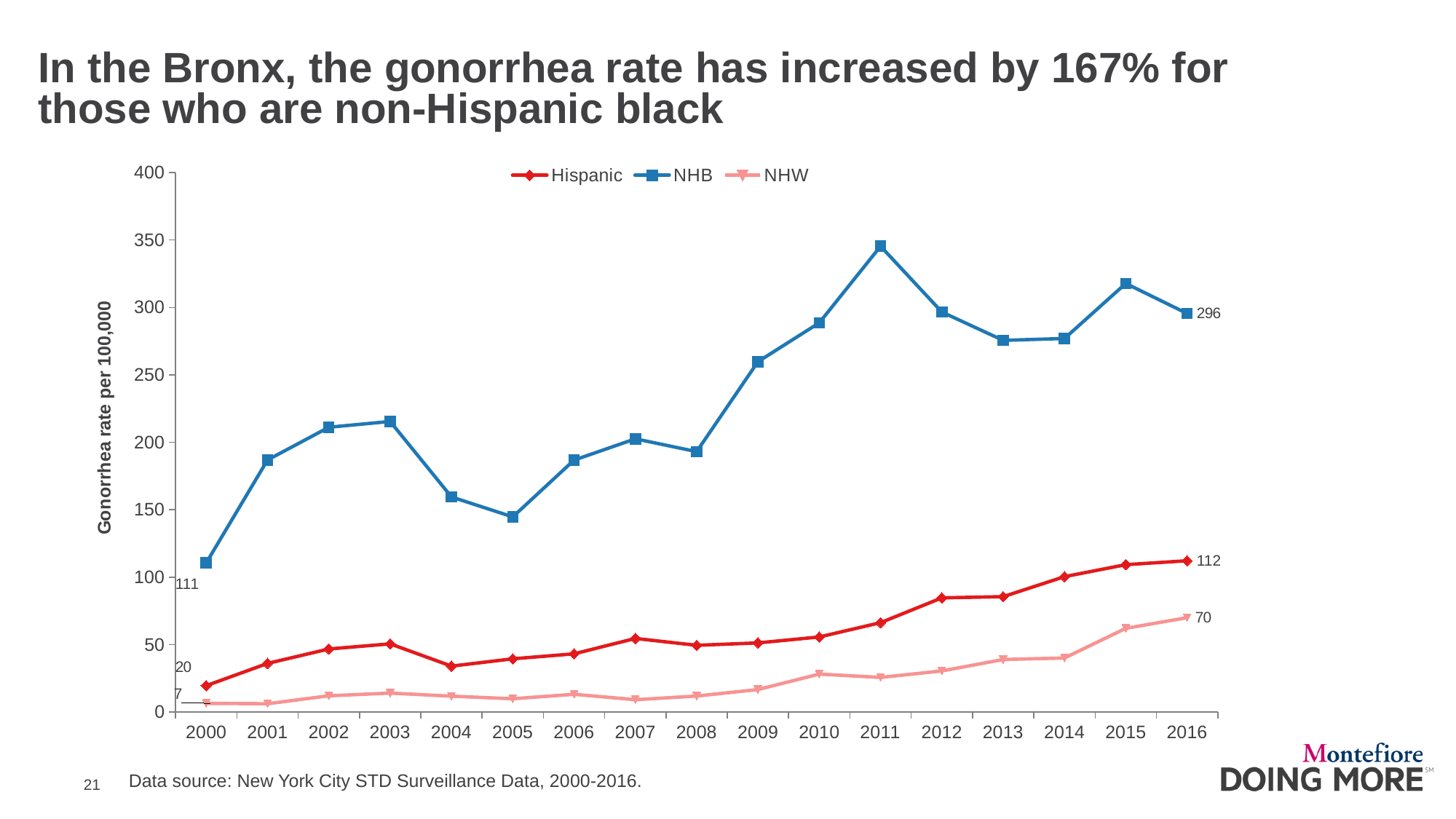
What is the gonorrhea rate for Hispanic in 2016? 112 How many series does the legend list? 3 What is the gonorrhea rate for NHB in 2000? 111 By how much did the NHB gonorrhea rate increase from 2000 to 2016? 185 What is the gonorrhea rate for NHB in 2016? 296 What is the difference between the NHB and Hispanic gonorrhea rates in 2016? 184 Is the NHB gonorrhea rate in 2011 greater or less than 300? greater In which year is the NHB gonorrhea rate highest? 2011 What is the gonorrhea rate for NHW in 2000? 7 What kind of chart is shown on the slide? line chart What is the title of the vertical axis? Gonorrhea rate per 100,000 In which year is the NHB gonorrhea rate lowest? 2000